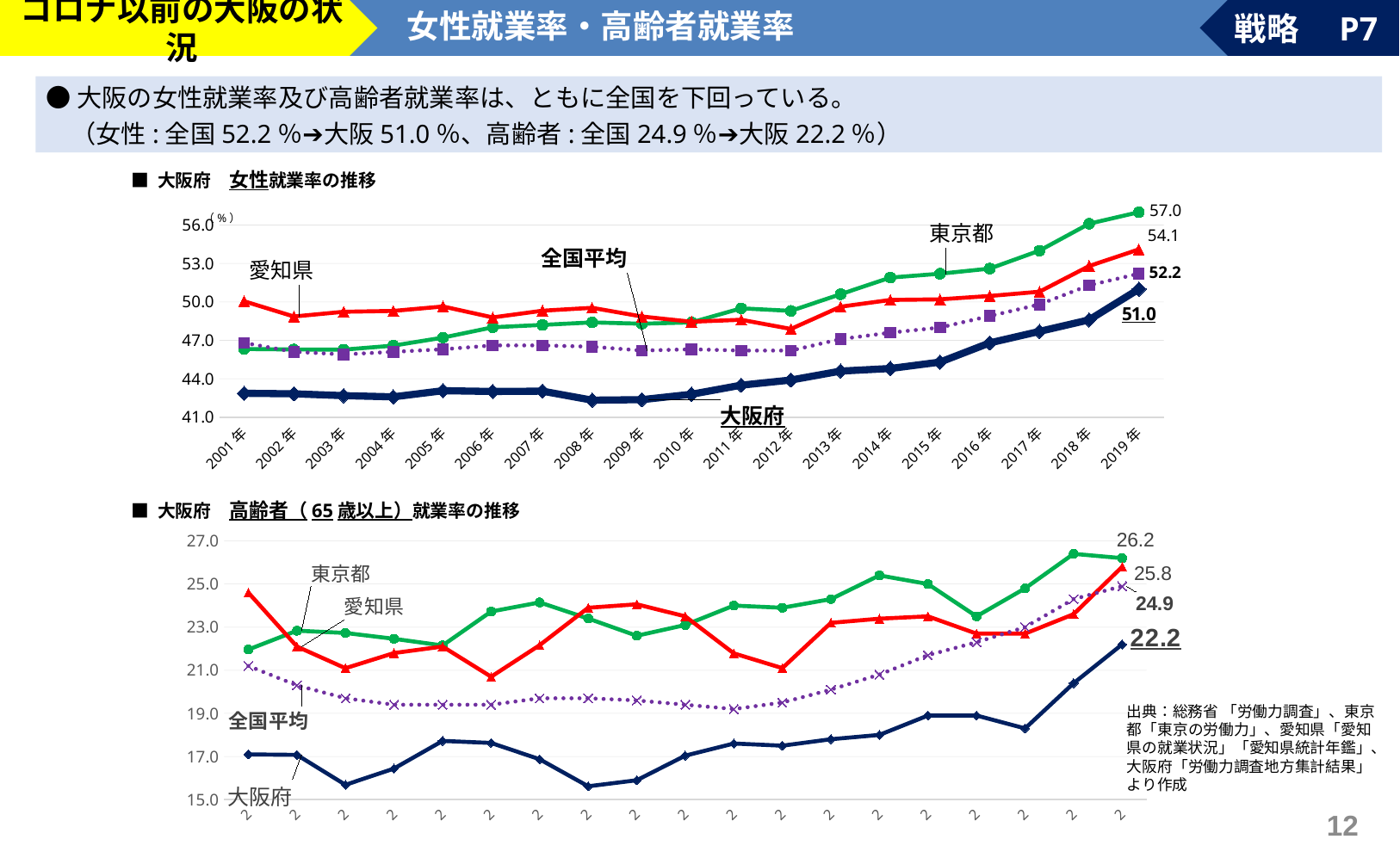
In the bottom chart (高齢者就業率の推移), what is the final labelled value for 大阪府? 22.2 In the top chart (女性就業率の推移), is the value for 大阪府 in 2001年 greater or less than 44.0? less In the top chart (女性就業率の推移), what is the difference between 全国平均 and 大阪府 in 2019年? 1.2 How many years are shown on the x axis of the top chart (女性就業率の推移)? 19 In the top chart (女性就業率の推移), what is the value for 大阪府 in 2019年? 51.0 In the top chart (女性就業率の推移), which series has the highest value in 2019年? 東京都 What kind of chart is the top chart (大阪府 女性就業率の推移)? line chart In the bottom chart (高齢者就業率の推移), what is the difference between the final labelled values of 全国平均 and 大阪府? 2.7 In the top chart (女性就業率の推移), what is the value for 東京都 in 2019年? 57.0 In the top chart (女性就業率の推移), what is the value for 全国平均 in 2019年? 52.2 In the top chart (女性就業率の推移), which series has the lowest value in 2019年? 大阪府 In the top chart (女性就業率の推移), does the 大阪府 line overall rise or fall from 2001年 to 2019年? rise